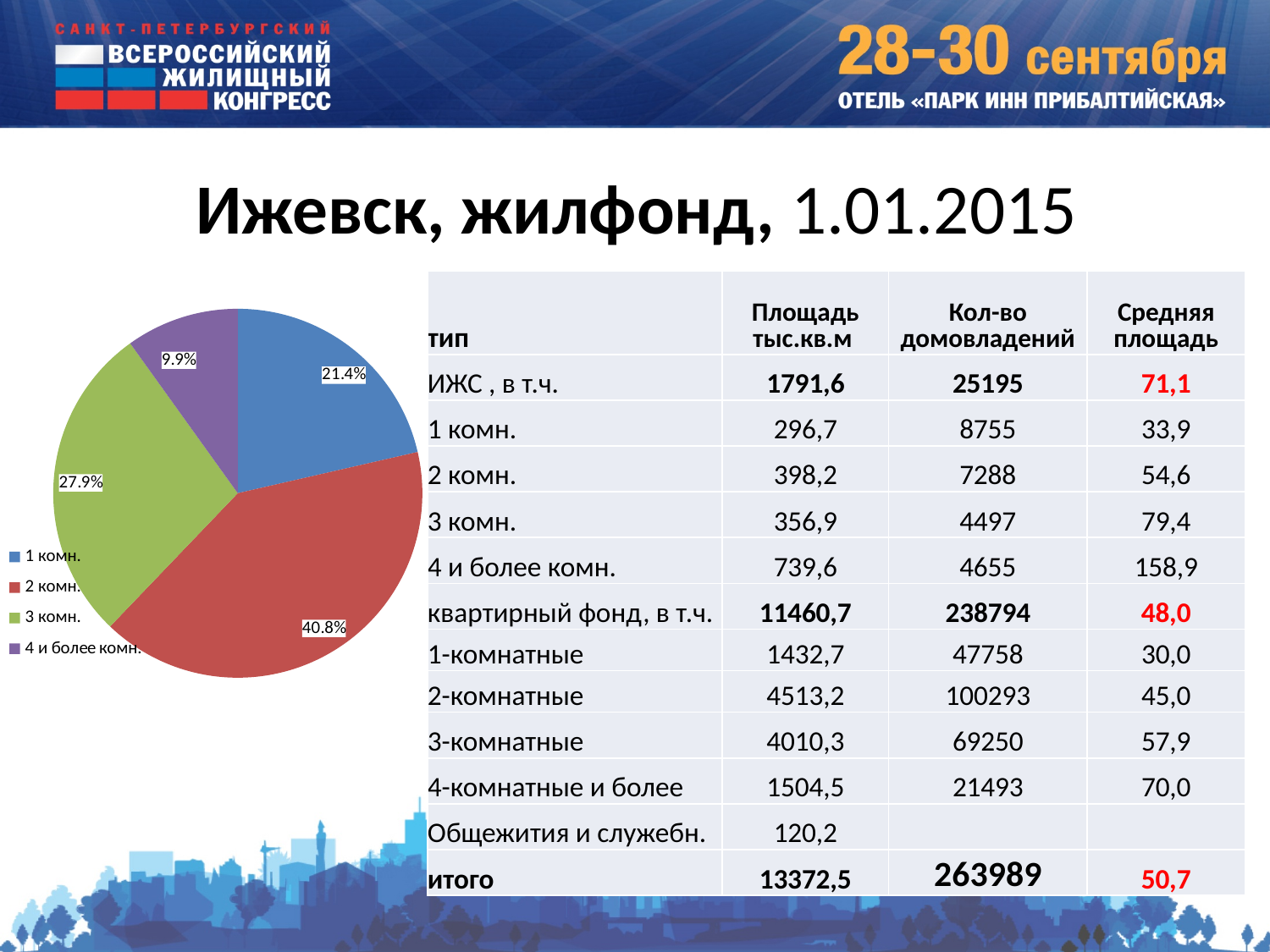
What share of the pie chart does the "2 комн." slice have? 40.8% Which category has the smallest slice in the pie chart? 4 и более комн. How many slices does the pie chart have? 4 Which category has the largest slice in the pie chart? 2 комн. What share of the pie chart does the "1 комн." slice have? 21.4% Which slice is larger in the pie chart: "3 комн." or "1 комн."? 3 комн. What is the difference in percentage points between the "2 комн." slice and the "1 комн." slice? 19.4 What share of the pie chart does the "4 и более комн." slice have? 9.9% What share of the pie chart does the "3 комн." slice have? 27.9% What colour is the "3 комн." slice in the pie chart? green What kind of chart is shown on the slide? pie chart How many entries does the legend of the pie chart list? 4